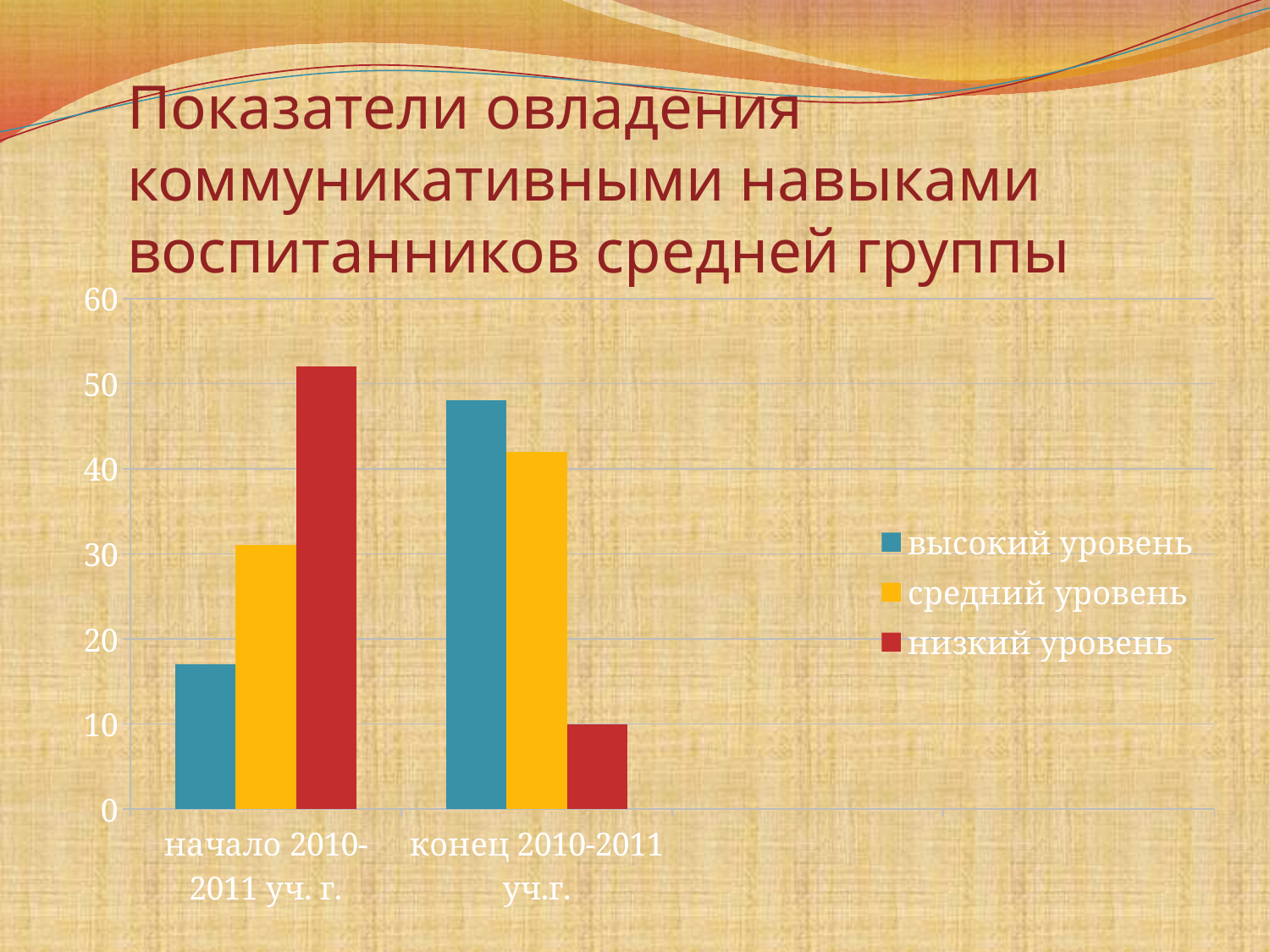
For "высокий уровень", which category has the larger value: "начало 2010-2011 уч. г." or "конец 2010-2011 уч.г."? конец 2010-2011 уч.г. Is the value for "высокий уровень" at "начало 2010-2011 уч. г." greater or less than 20? less What kind of chart is shown on the slide? bar chart What colour represents "средний уровень" in the chart's legend? yellow Does the value for "низкий уровень" rise or fall from "начало 2010-2011 уч. г." to "конец 2010-2011 уч.г."? fall Which series has the highest value for "конец 2010-2011 уч.г."? высокий уровень Which series has the highest value for "начало 2010-2011 уч. г."? низкий уровень How many series does the chart's legend list? 3 How many categories are shown on the x axis of the chart? 2 Is the value for "низкий уровень" at "начало 2010-2011 уч. г." greater or less than 50? greater Which series has the lowest value for "конец 2010-2011 уч.г."? низкий уровень Which series has the lowest value for "начало 2010-2011 уч. г."? высокий уровень